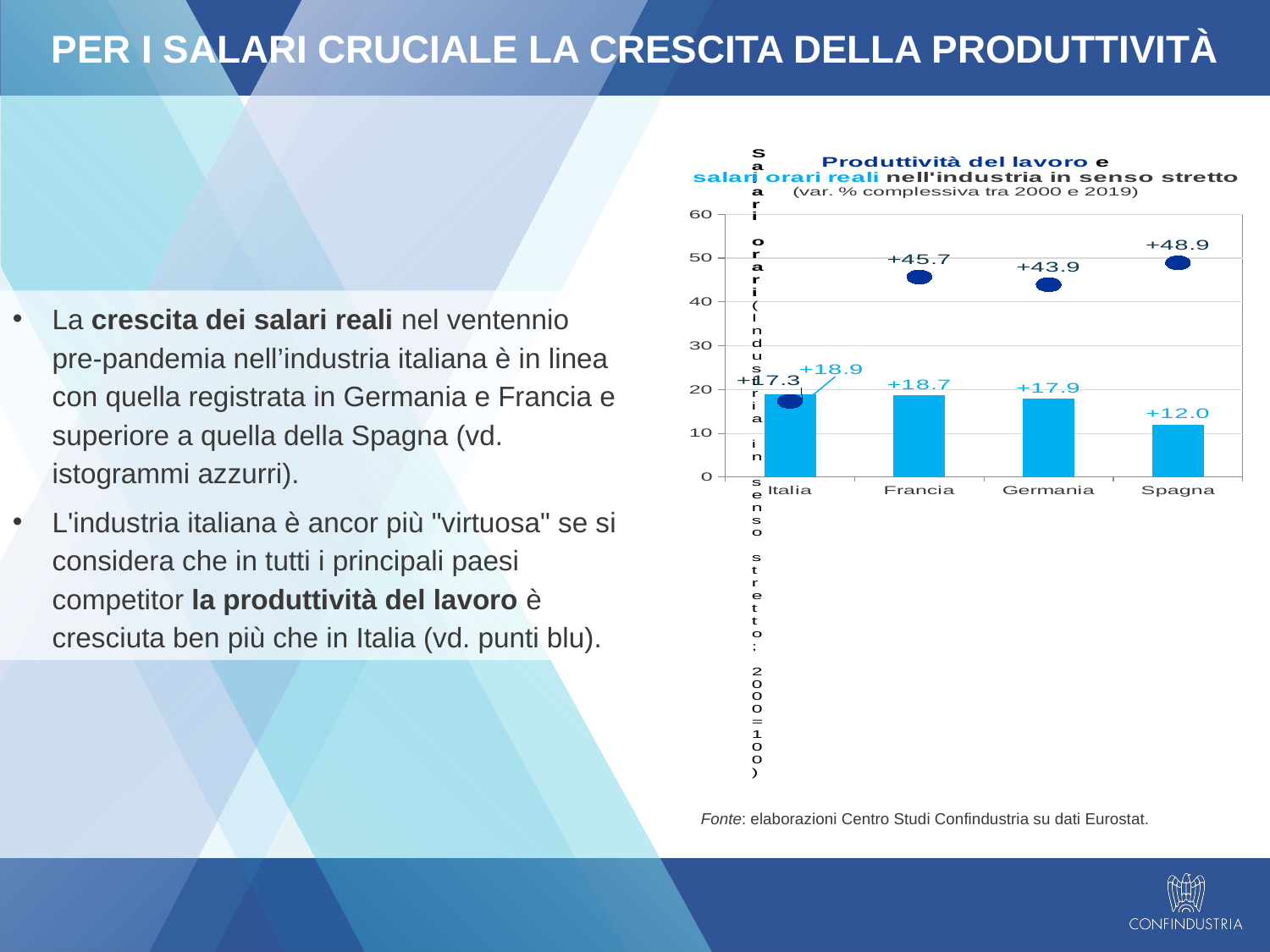
What is the real hourly wage growth (bar) shown for Spagna? +12.0 What is the real hourly wage growth (bar) shown for Germania? +17.9 What is the difference between the labour productivity growth of Spagna and Italia? 31.6 What is the labour productivity growth (blue point) shown for Italia? +17.3 Which country has the highest labour productivity growth (blue point)? Spagna How many countries are shown on the x axis? 4 Which country has the lowest real hourly wage growth (bar)? Spagna Is the labour productivity growth for Germania greater or less than 40? greater Which country has the lowest labour productivity growth (blue point)? Italia What period does the chart subtitle say the cumulative % change covers? 2000 to 2019 What is the labour productivity growth (blue point) shown for Francia? +45.7 Is the labour productivity growth for Francia larger than its real hourly wage growth? Yes